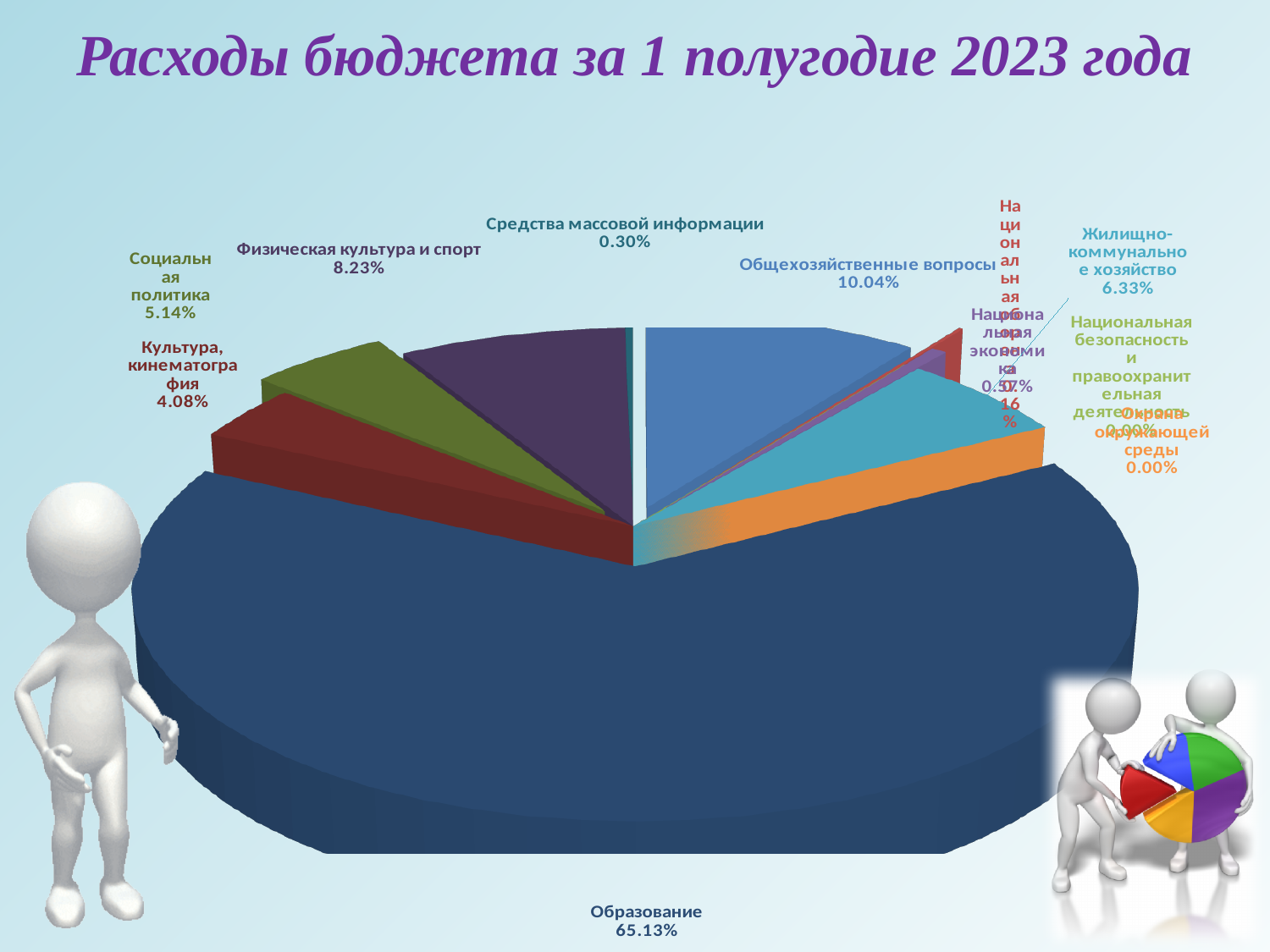
What is the title of the chart on the slide? Расходы бюджета за 1 полугодие 2023 года What share of the budget expenses goes to Образование? 65.13% Which has a larger share: Культура, кинематография or Социальная политика? Социальная политика What percentage is shown for Жилищно-коммунальное хозяйство? 6.33% What is the difference in percentage points between Физическая культура и спорт and Культура, кинематография? 4.15 What percentage is shown for Общехозяйственные вопросы? 10.04% What type of chart is shown on the slide? Pie chart What percentage is shown for Социальная политика? 5.14% What is the difference in percentage points between Образование and Общехозяйственные вопросы? 55.09 Which category has the largest share of the budget expenses? Образование What percentage is shown for Средства массовой информации? 0.30% What percentage is shown for Физическая культура и спорт? 8.23%